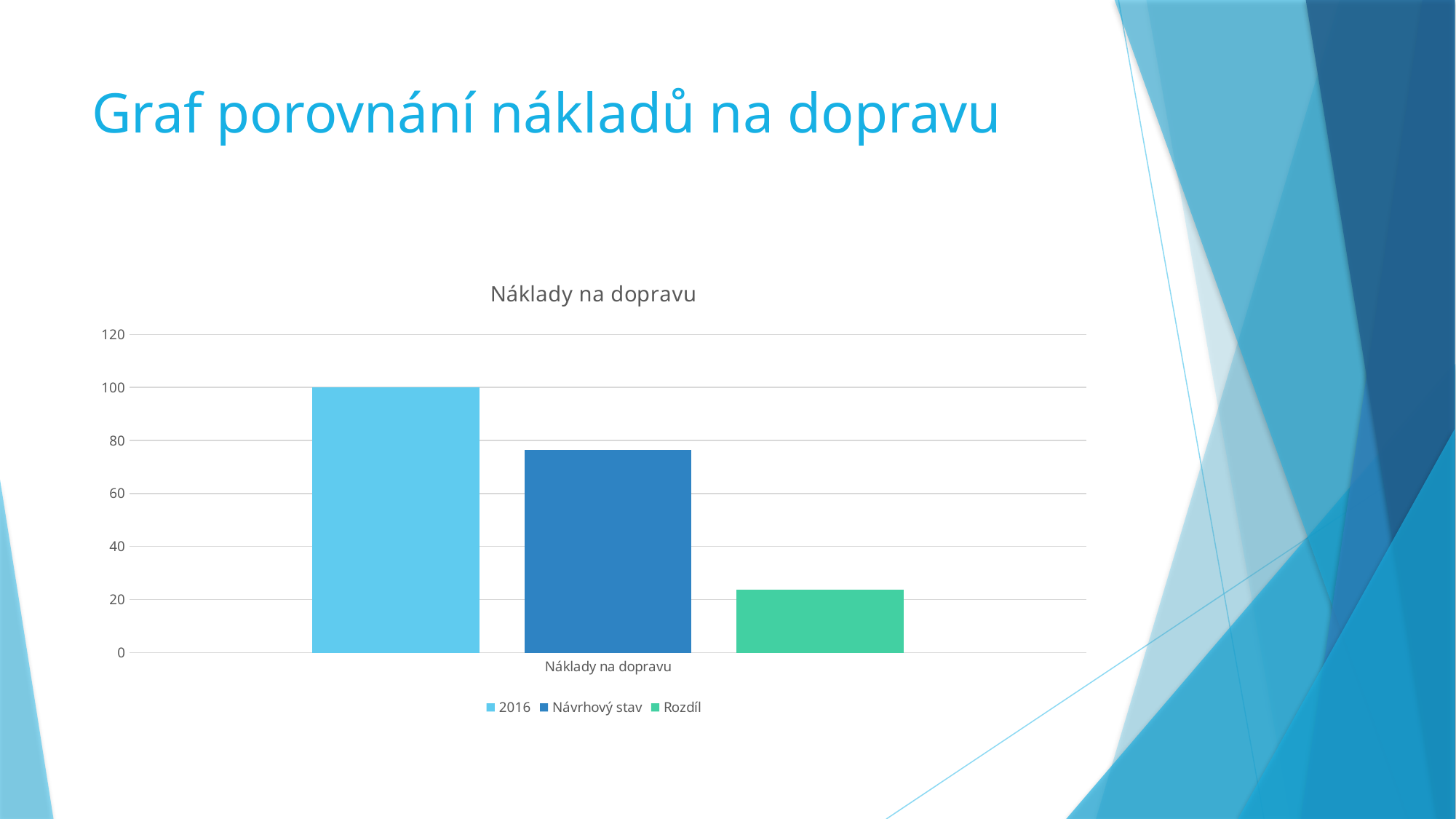
What kind of chart is shown on the slide? bar chart What is the value of the 2016 bar? 100 How many categories are shown on the x axis? 1 Which is larger, the bar for Návrhový stav or the bar for Rozdíl? Návrhový stav Which series has the highest bar? 2016 Which series has the lowest bar? Rozdíl Is the value for Návrhový stav greater or less than 80? less Is the value for Rozdíl greater or less than 40? less Is the value for Návrhový stav greater or less than 60? greater Which series is shown in green in the legend? Rozdíl What is the title of the chart? Náklady na dopravu How many series does the legend list? 3